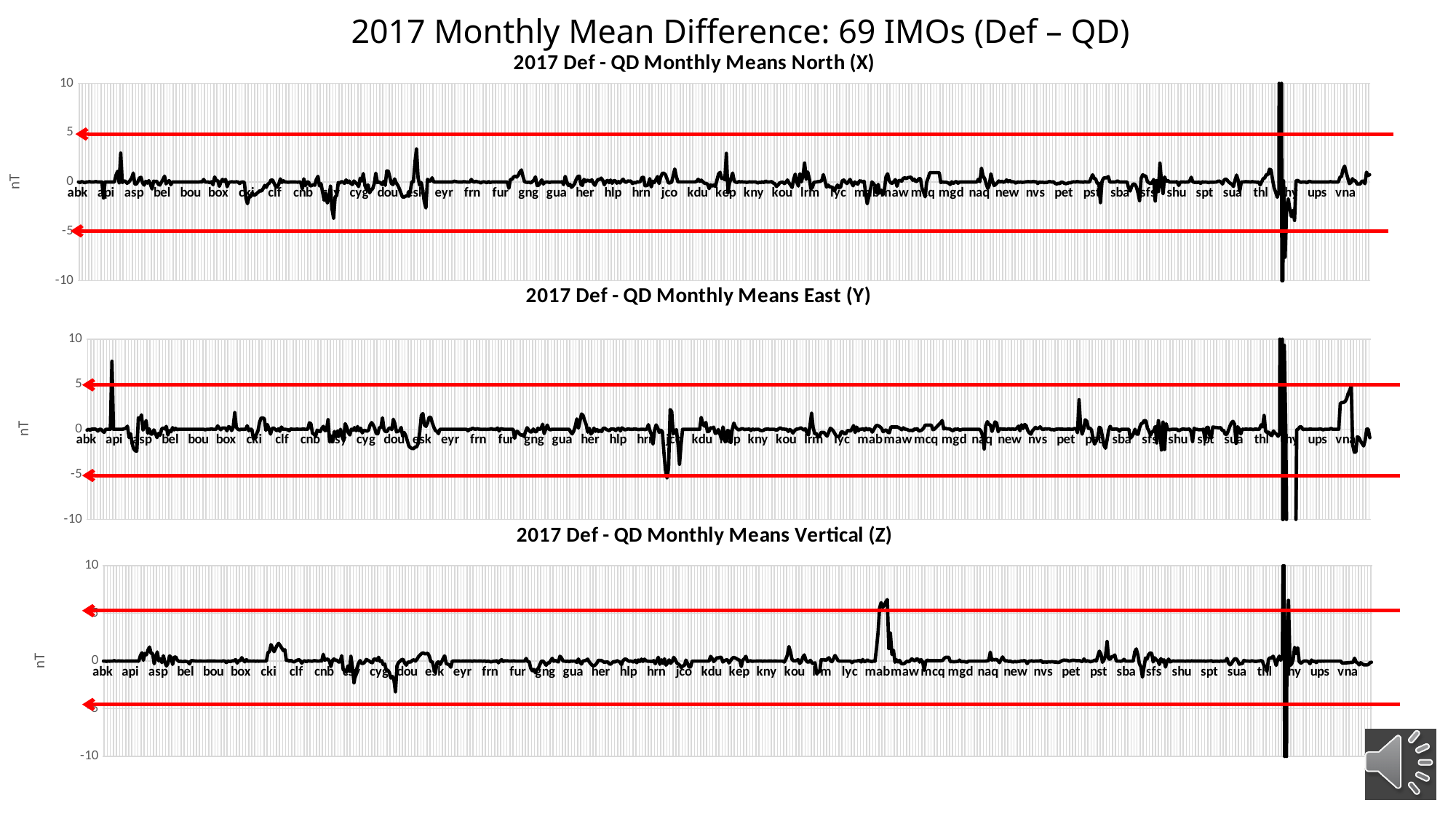
How many charts are shown on the slide? 3 In the "2017 Def - QD Monthly Means East (Y)" chart, what unit is shown on the vertical axis? nT What is the title of the bottom chart? 2017 Def - QD Monthly Means Vertical (Z) In the "2017 Def - QD Monthly Means East (Y)" chart, is the peak value at api greater or less than 5? greater In the "2017 Def - QD Monthly Means North (X)" chart, what is the highest value shown on the vertical axis? 10 What is the title of the top chart? 2017 Def - QD Monthly Means North (X) In the "2017 Def - QD Monthly Means East (Y)" chart, what is the first station label on the x axis? abk In the "2017 Def - QD Monthly Means Vertical (Z)" chart, what is the lowest value shown on the vertical axis? -10 In the "2017 Def - QD Monthly Means Vertical (Z)" chart, is the peak value at mab greater or less than 5? greater In the "2017 Def - QD Monthly Means North (X)" chart, is the peak value at esk greater or less than 5? less What kind of chart is the "2017 Def - QD Monthly Means North (X)" chart? line chart According to the slide title, how many IMOs are included in the 2017 monthly mean difference? 69